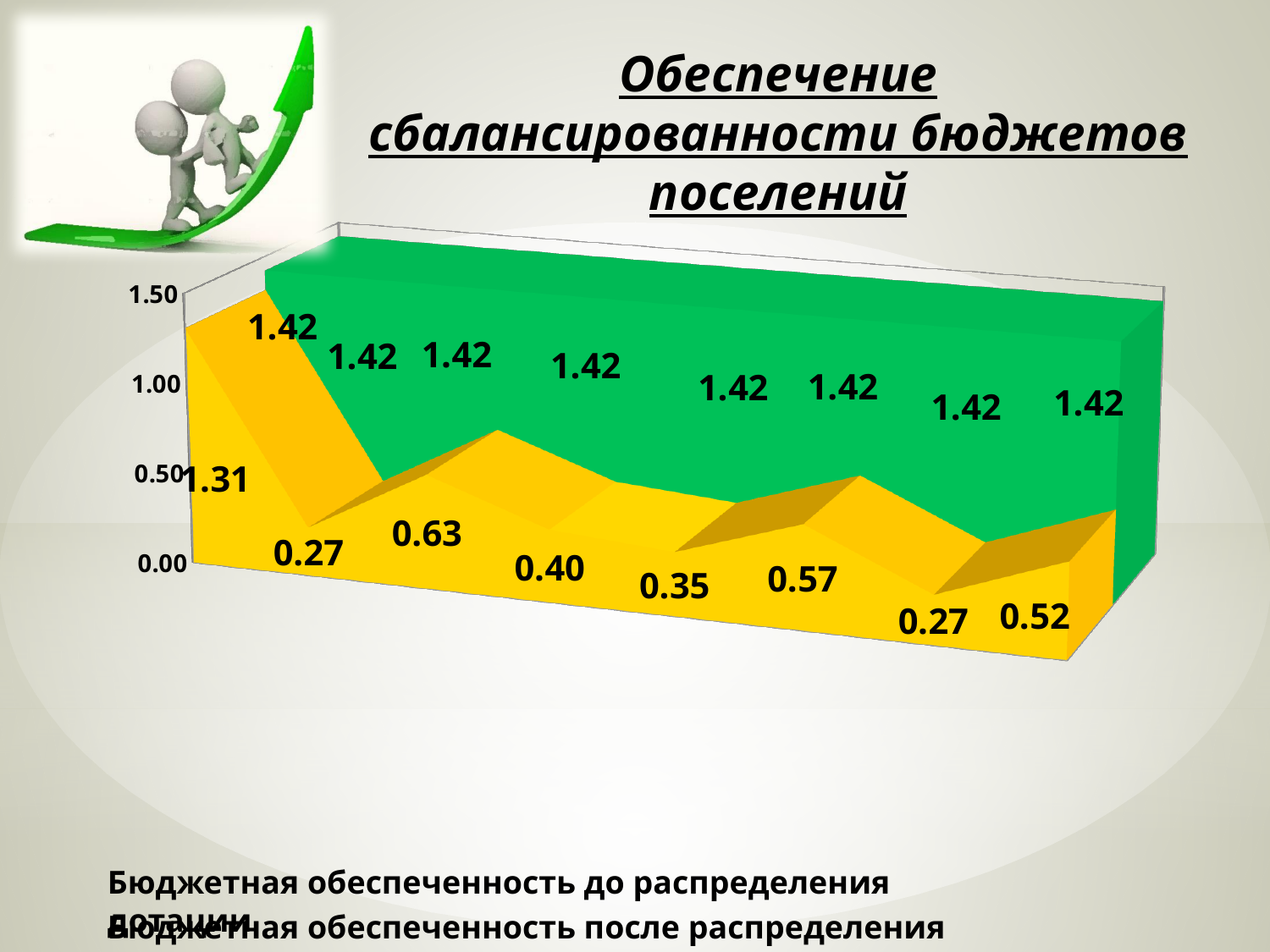
How many data points does each series in the chart have? 8 What value is shown for every point of the 'Бюджетная обеспеченность после распределения дотации' series? 1.42 What is the lowest value in the 'Бюджетная обеспеченность до распределения дотации' series? 0.27 What is the title of the slide containing the chart? Обеспечение сбалансированности бюджетов поселений Which series has the larger values at every point: 'до распределения дотации' or 'после распределения дотации'? после распределения дотации What is the value of the last point of the 'Бюджетная обеспеченность до распределения дотации' series? 0.52 Does the 'до распределения дотации' series rise or fall from its first point to its second point? fall What is the difference between the first point of the 'после распределения дотации' series (1.42) and the first point of the 'до распределения дотации' series (1.31)? 0.11 How many data series does the chart's legend list? 2 What is the highest value in the 'Бюджетная обеспеченность до распределения дотации' series? 1.31 What kind of chart is shown on the slide? Area chart Is the value of the 'после распределения дотации' series greater or less than 1.00? greater